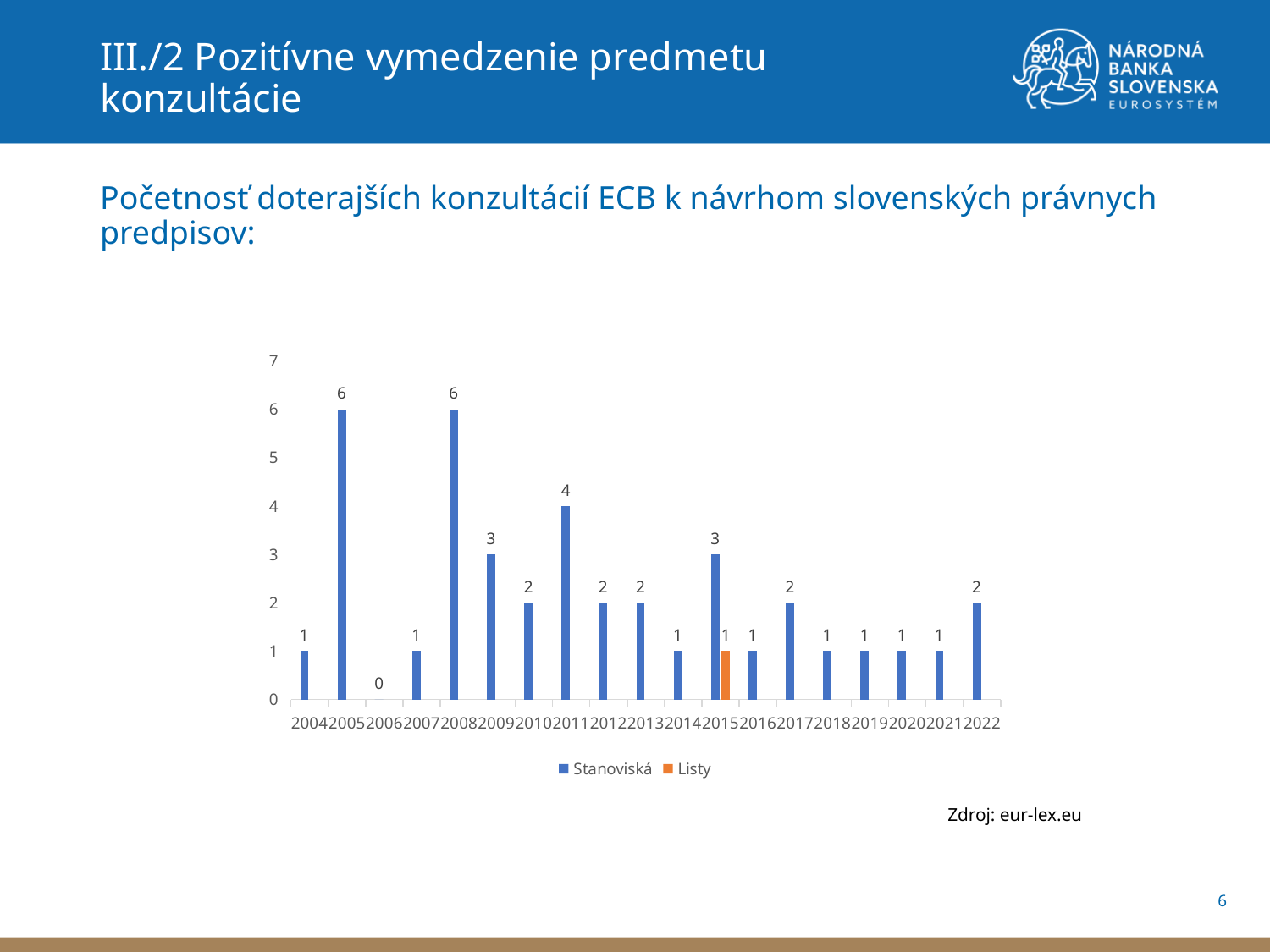
Which year has a larger Stanoviská value, 2011 or 2017? 2011 Which year has the lowest value of Stanoviská? 2006 How many years are shown on the x axis? 19 What is the difference between the Stanoviská values for 2008 and 2009? 3 Which series is shown in orange in the legend? Listy How many series does the legend list? 2 What is the value of Stanoviská for 2011? 4 What is the highest value of Stanoviská shown in the chart? 6 What is the value of Listy for 2015? 1 What is the value of Stanoviská for 2009? 3 What kind of chart is shown on the slide? bar chart